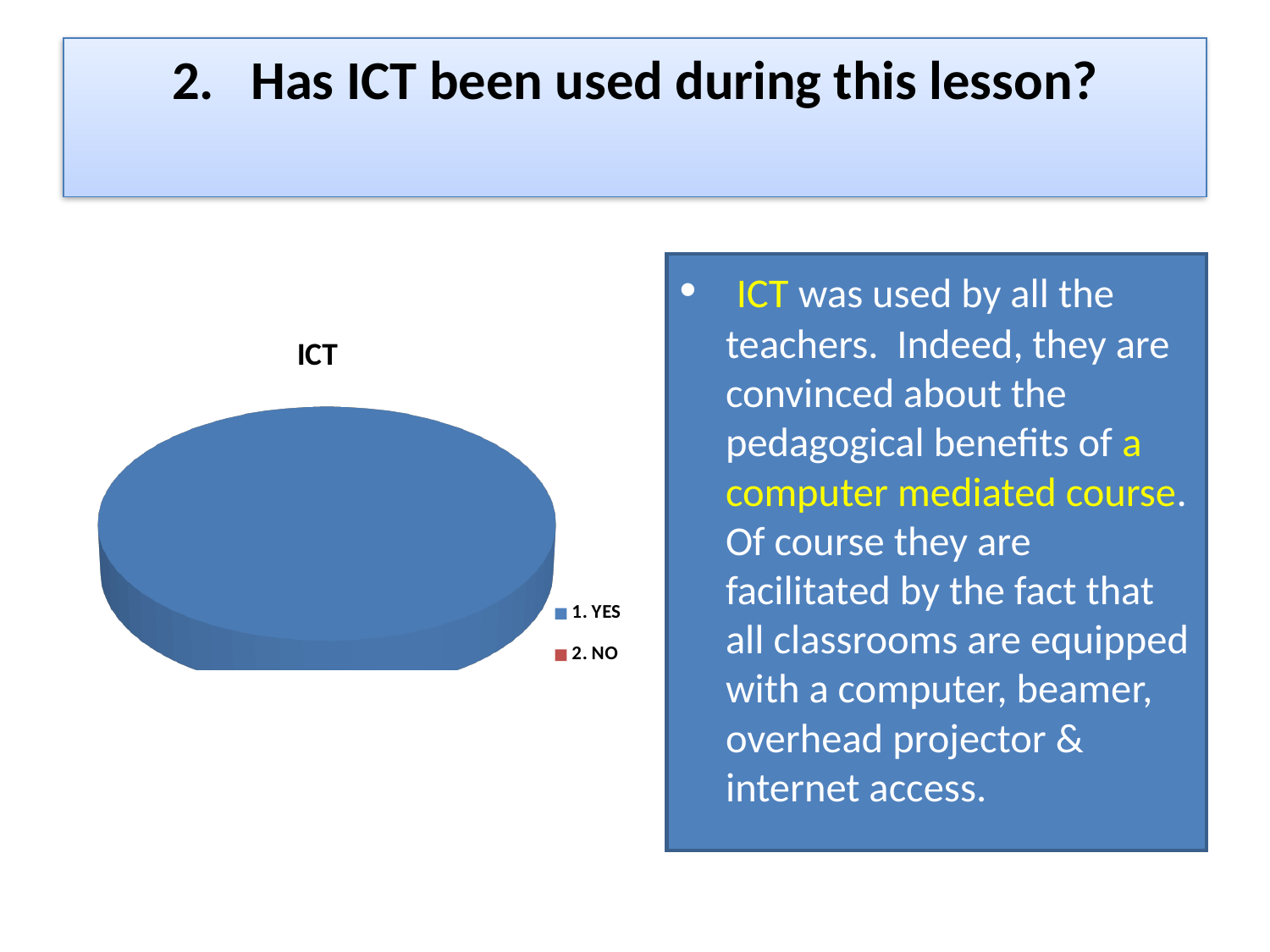
What kind of chart is shown on the slide? pie chart What colour represents the 1. YES category in the legend? blue Which category has the largest slice of the pie? 1. YES Which is larger in the pie, the slice for 1. YES or the slice for 2. NO? 1. YES What is the title of the chart? ICT How many entries does the chart's legend list? 2 Is the share of the pie for 1. YES greater or less than 50%? greater Which category has the smallest slice of the pie? 2. NO